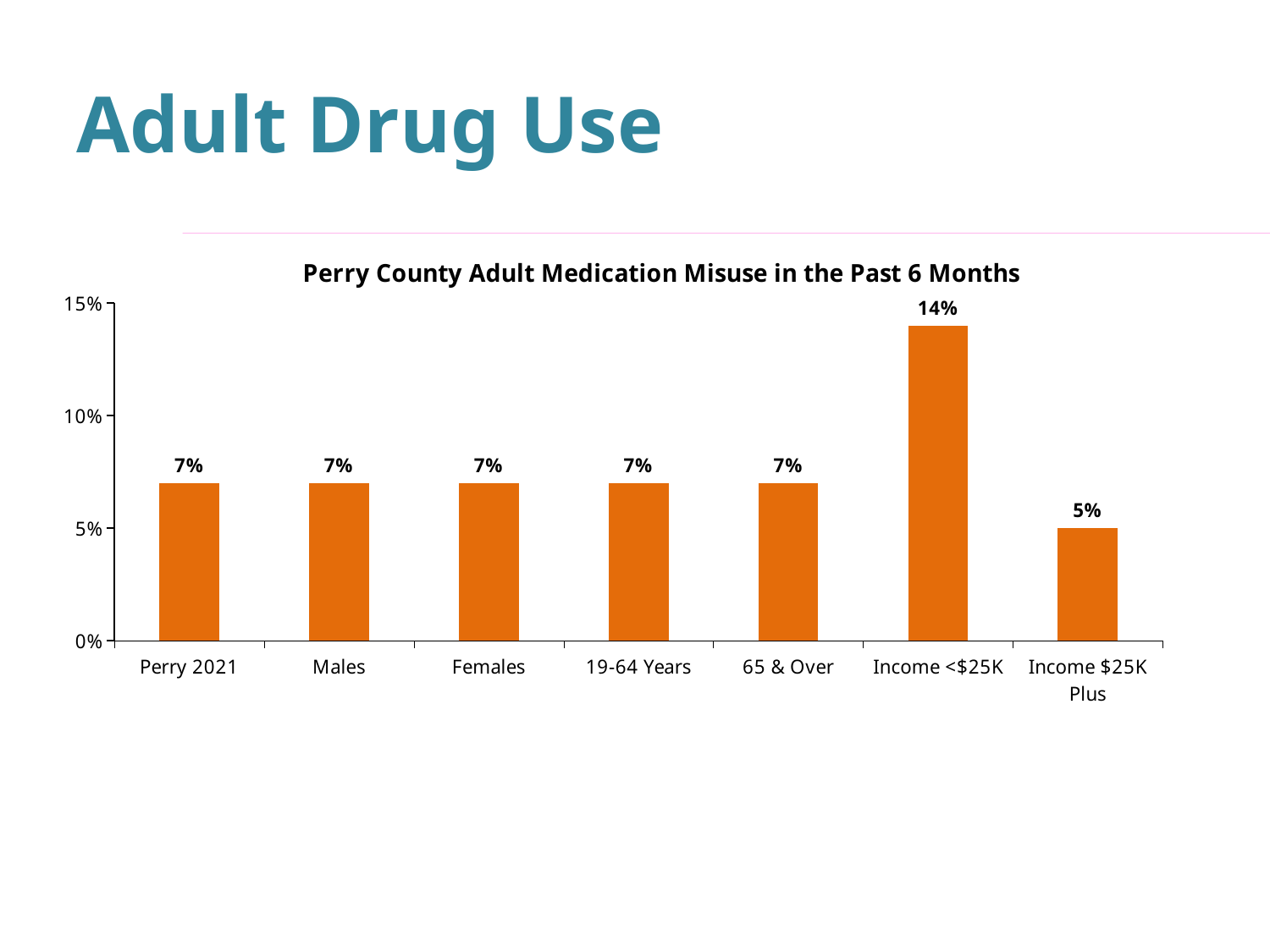
How many categories are shown on the x axis? 7 Is the value for Income <$25K greater or less than 10%? greater What is the value for 65 & Over? 7% What kind of chart is shown on the slide? Bar chart Which is larger, the value for Females or the value for Income $25K Plus? Females Which category has the lowest value? Income $25K Plus What is the value for Perry 2021? 7% What is the value for Income $25K Plus? 5% What is the value for Income <$25K? 14% Which category has the highest value? Income <$25K What is the difference between the values for Income <$25K and Males? 7% What is the difference between the values for Income <$25K and Income $25K Plus? 9%